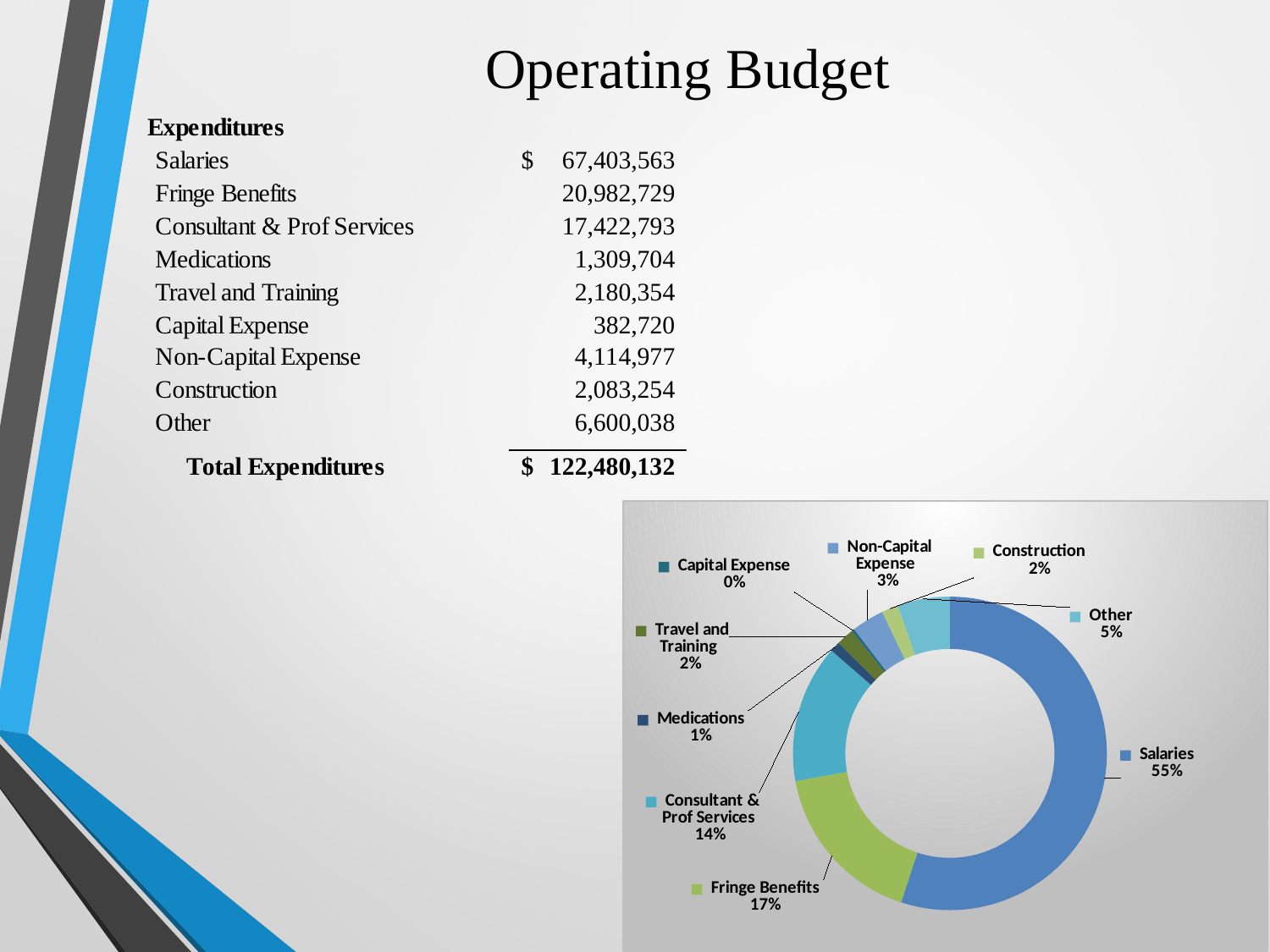
What percentage is shown for Medications in the chart? 1% Which has a larger share in the chart, Consultant & Prof Services or Other? Consultant & Prof Services Which category has the smallest share in the chart? Capital Expense What percentage is shown for Other in the chart? 5% Which category has the largest share in the chart? Salaries What percentage is shown for Consultant & Prof Services in the chart? 14% What kind of chart is shown on the slide? doughnut chart What share of the chart does Salaries represent? 55% What is the difference in percentage points between Salaries and Fringe Benefits in the chart? 38 How many categories are shown in the chart? 9 What percentage is shown for Non-Capital Expense in the chart? 3% What percentage is shown for Fringe Benefits in the chart? 17%